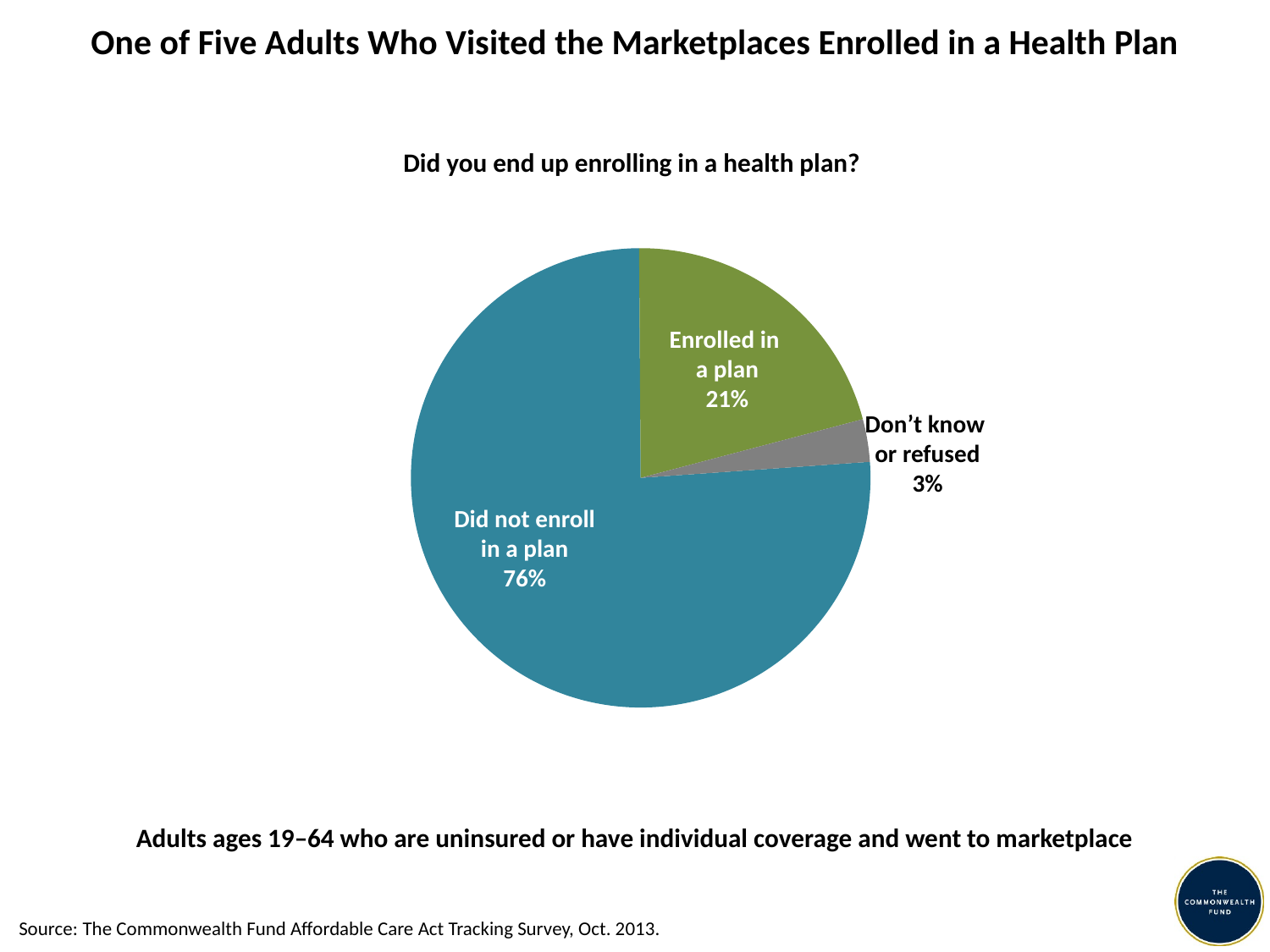
Which slice of the pie is the largest? Did not enroll in a plan What question is the pie chart answering, as shown above the chart? Did you end up enrolling in a health plan? What is the difference in percentage points between 'Did not enroll in a plan' and 'Enrolled in a plan'? 55 What percentage of adults enrolled in a plan? 21% What percentage of adults answered 'Don't know or refused'? 3% Which slice of the pie is the smallest? Don't know or refused What percentage of adults did not enroll in a plan? 76% Which is larger: the share that enrolled in a plan or the share that answered 'Don't know or refused'? Enrolled in a plan What kind of chart is shown on the slide? Pie chart How many slices does the pie chart have? 3 What colour is the 'Enrolled in a plan' slice? Green What share of the pie does the 'Enrolled in a plan' slice represent? 21%